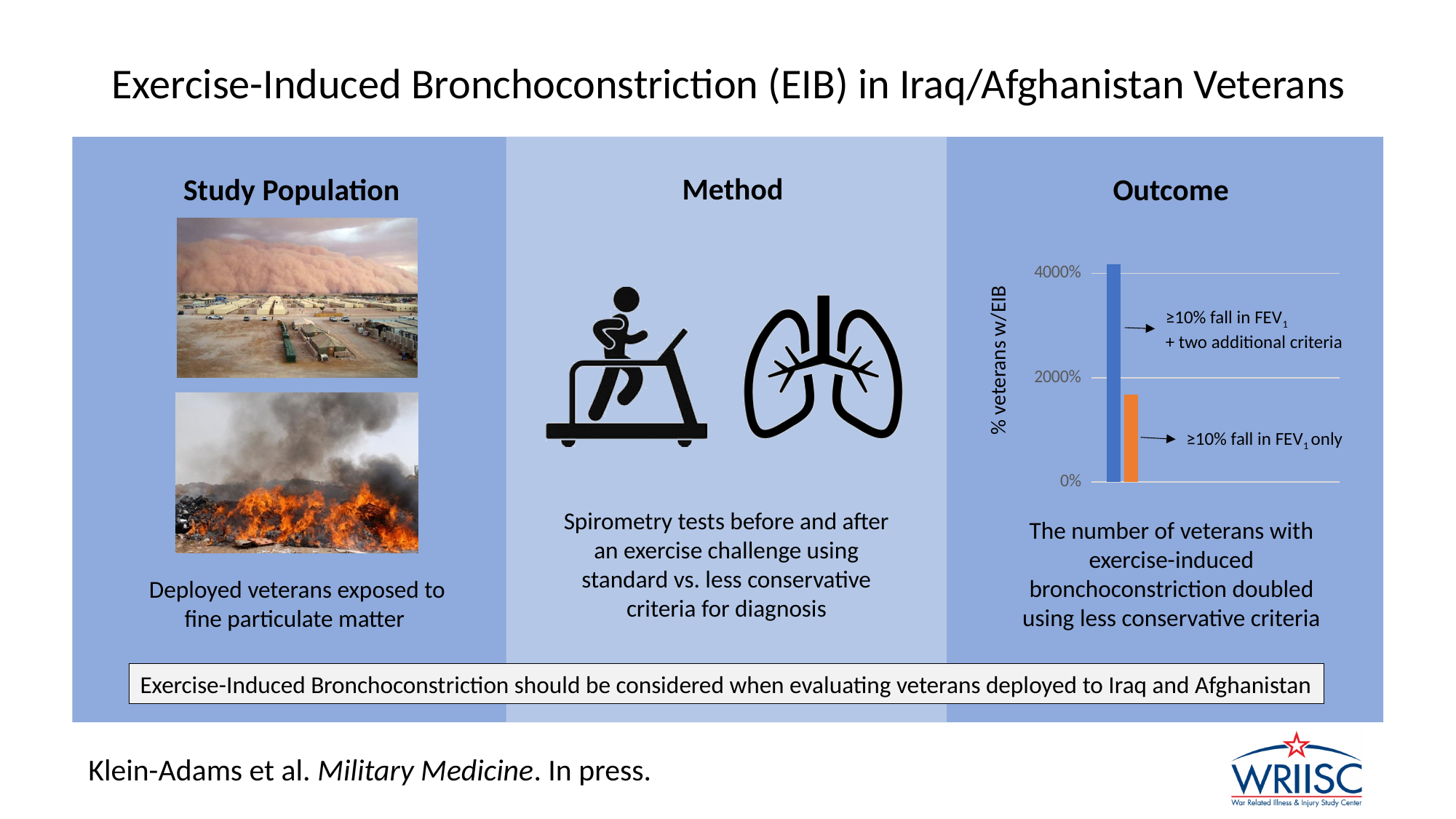
In the Outcome chart, is the value for '≥10% fall in FEV1 only' greater or less than 2000%? less What is the highest tick value shown on the vertical axis of the Outcome chart? 4000% In the Outcome chart, which bar is higher: the one for '≥10% fall in FEV1 + two additional criteria' or the one for '≥10% fall in FEV1 only'? ≥10% fall in FEV1 + two additional criteria How many bars are plotted in the Outcome chart? 2 What kind of chart is shown in the Outcome panel? bar chart In the Outcome chart, which criterion has the highest % veterans w/EIB? ≥10% fall in FEV1 + two additional criteria What is the label on the vertical axis of the Outcome chart? % veterans w/EIB In the Outcome chart, is the value for '≥10% fall in FEV1 + two additional criteria' greater or less than 2000%? greater In the Outcome chart, which criterion has the lowest % veterans w/EIB? ≥10% fall in FEV1 only